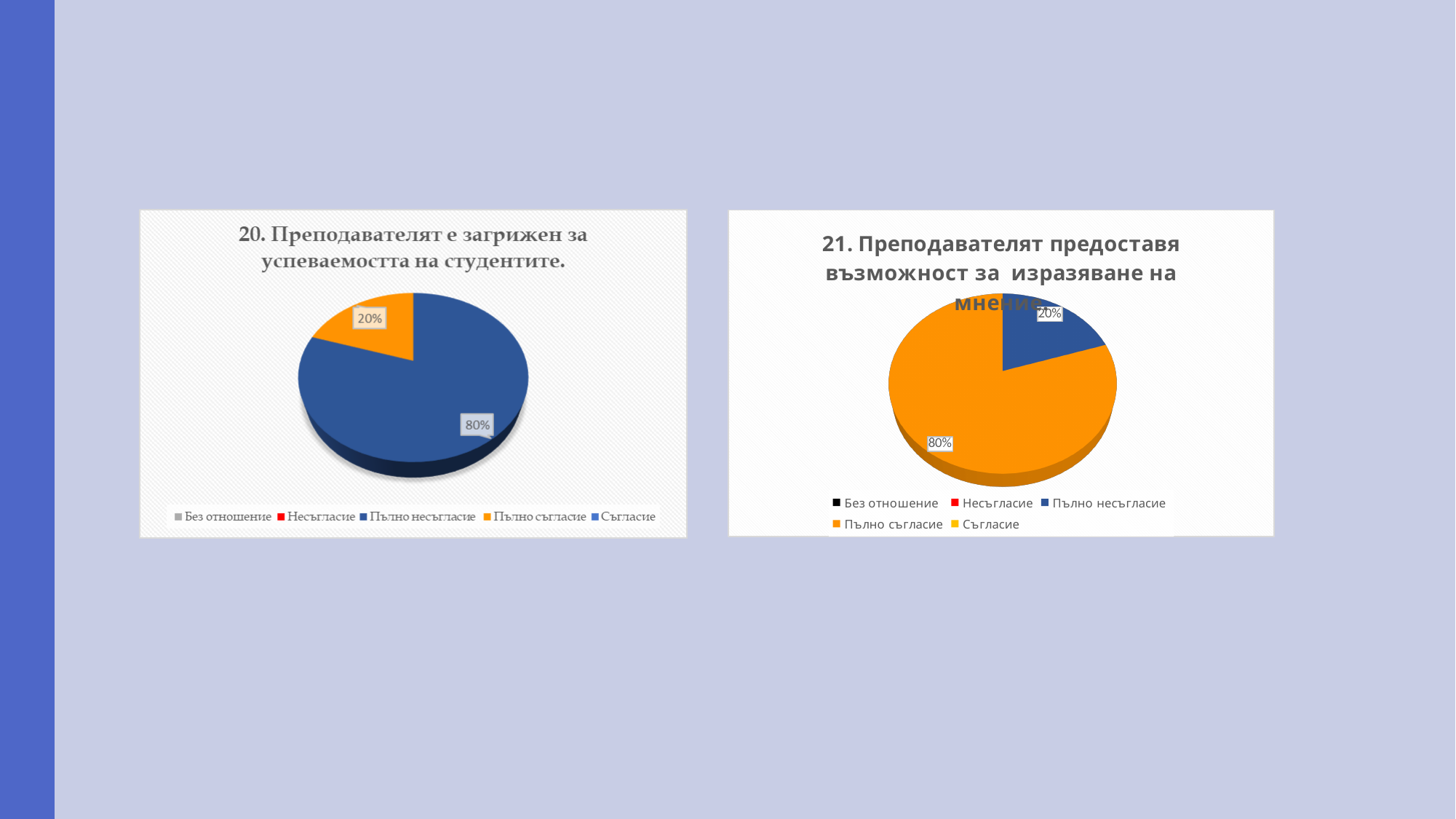
How many slices are visible in chart 21 (right)? 2 In chart 21 (right), which slice is the largest? the orange slice (Пълно съгласие) In chart 21 (right), which legend entry is shown in orange? Пълно съгласие How many entries does the legend of chart 21 (right) list? 5 What type of chart is used for chart 20 (left)? pie chart In chart 20 (left), which slice is larger, the blue one or the orange one? the blue one How many entries does the legend of chart 20 (left) list? 5 In chart 21 (right), what percentage does the orange slice represent? 80% In chart 20 (left), what percentage does the blue slice represent? 80% In chart 21 (right), what percentage does the blue slice represent? 20% In chart 20 (left), what is the difference in percentage points between the blue slice and the orange slice? 60 In chart 20 (left), what percentage does the orange slice represent? 20%